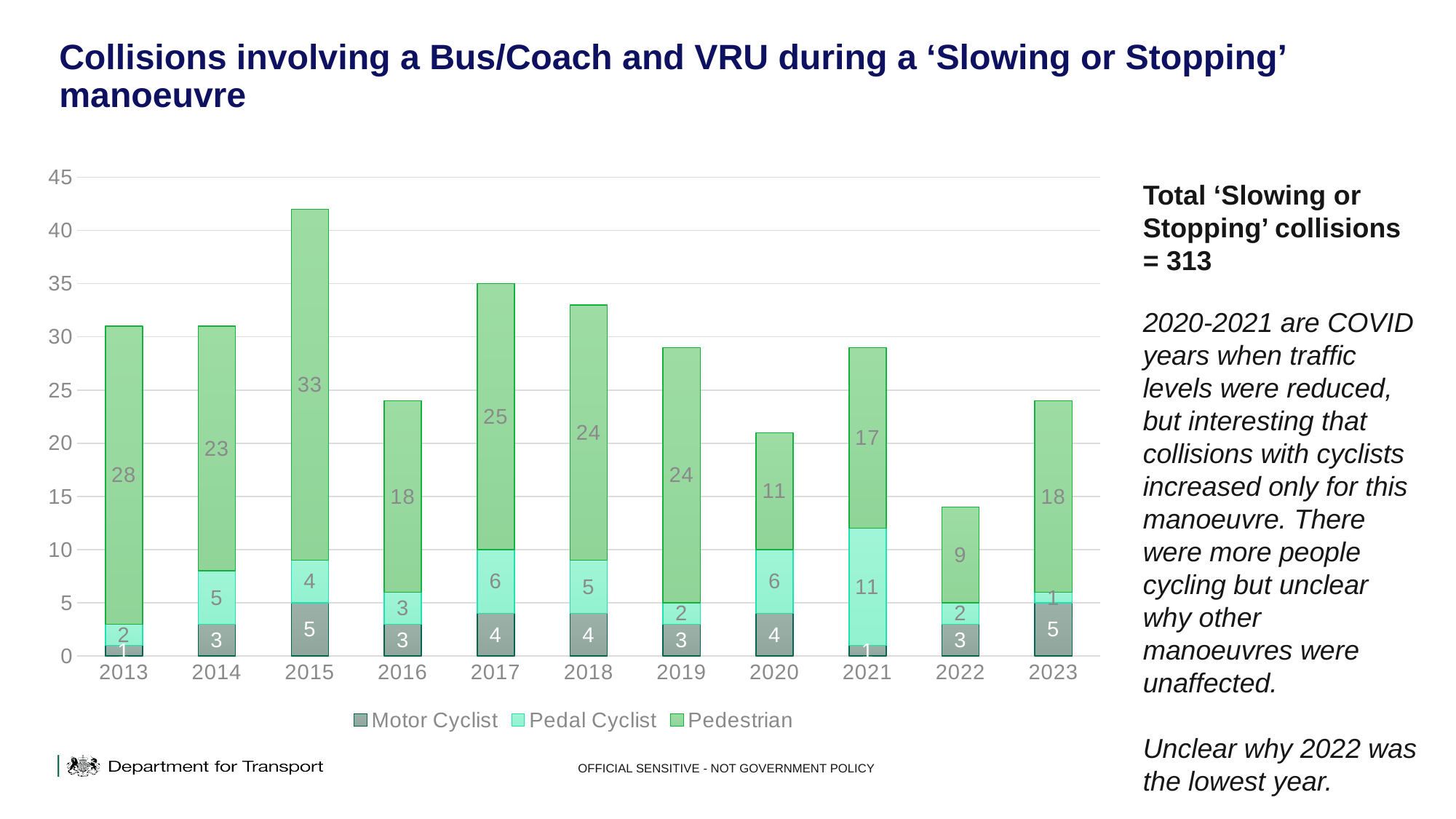
What is the total of the stacked bar for 2022? 14 How many years are shown on the x axis? 11 Which year has the highest Pedestrian value? 2015 Which is larger, the Pedal Cyclist value for 2020 or for 2019? 2020 What is the difference between the Pedestrian values for 2013 and 2014? 5 What is the Pedal Cyclist value for 2021? 11 What kind of chart is shown on the slide? Stacked bar chart What is the Motor Cyclist value for 2023? 5 Which year has the lowest Pedestrian value? 2022 How many series does the legend list? 3 Is the total of the stacked bar for 2015 greater or less than 40? greater What is the Pedestrian value for 2015? 33